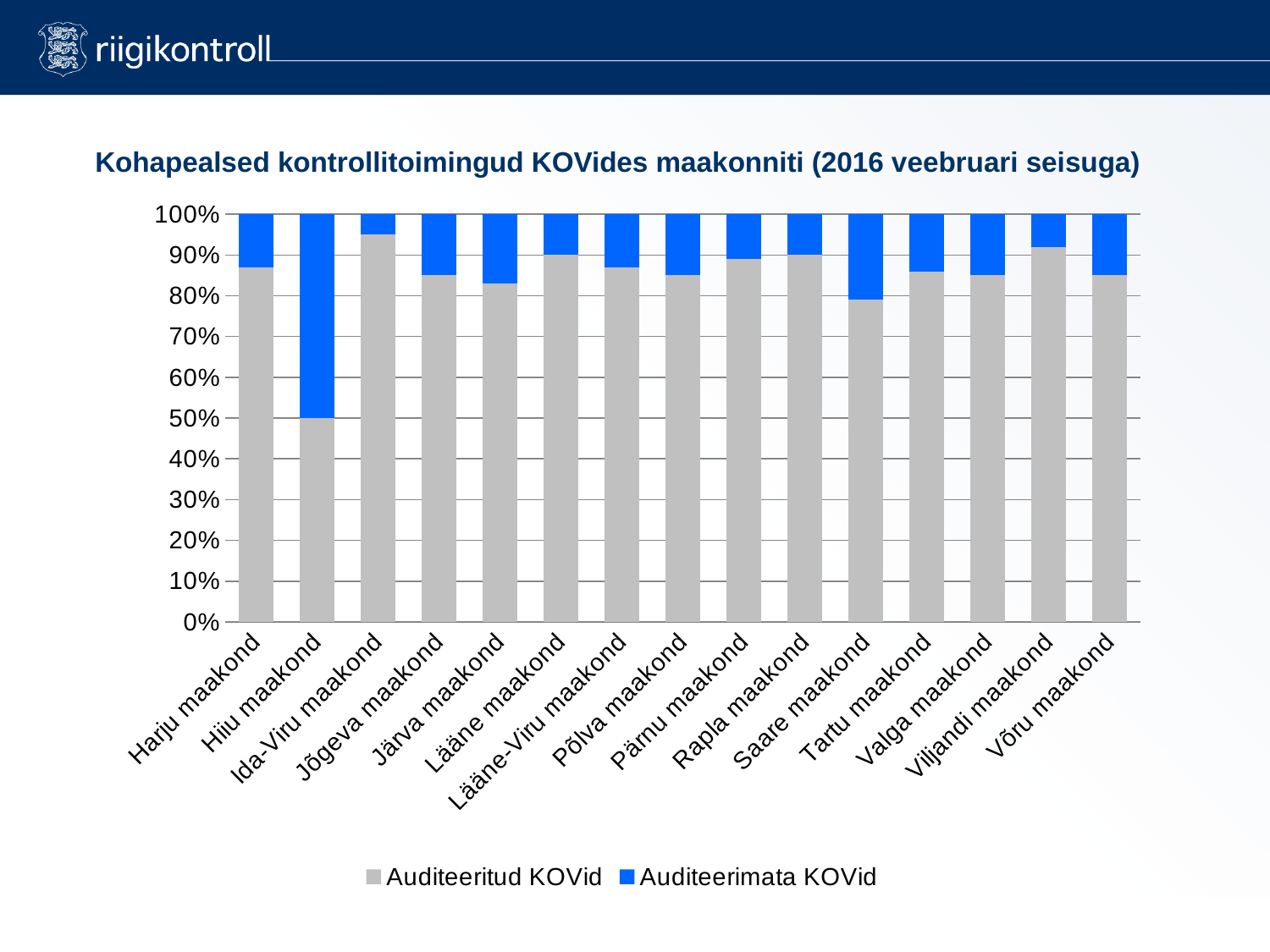
Is the Auditeeritud KOVid share for Hiiu maakond greater or less than 60%? less How many series does the legend list? 2 What is the total of the stacked bar for Harju maakond? 100% What is the title of the chart? Kohapealsed kontrollitoimingud KOVides maakonniti (2016 veebruari seisuga) Which county has the highest Auditeerimata KOVid share? Hiiu maakond Is the Auditeeritud KOVid share for Ida-Viru maakond greater or less than 90%? greater What is the Auditeeritud KOVid share for Hiiu maakond? 50% Which has the larger Auditeeritud KOVid share, Saare maakond or Tartu maakond? Tartu maakond Which county has the highest Auditeeritud KOVid share? Ida-Viru maakond What kind of chart is shown on the slide? Stacked bar chart Which county has the lowest Auditeeritud KOVid share? Hiiu maakond How many counties (categories) are shown on the x axis? 15